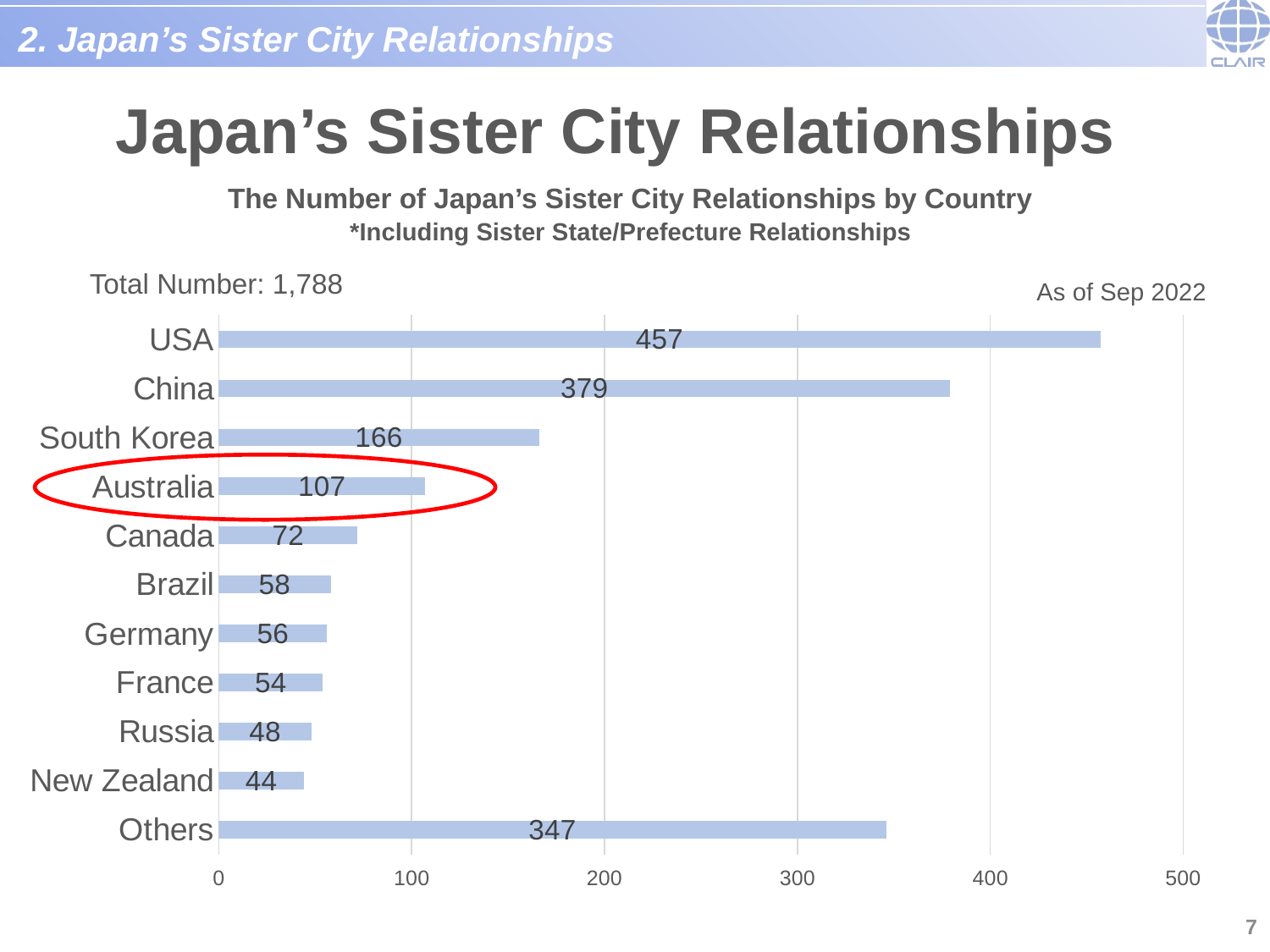
What kind of chart is shown on the slide? Bar chart How many sister city relationships does Japan have with the USA? 457 Which named country (excluding Others) has the lowest value on the chart? New Zealand What is the difference between the values for USA and China? 78 What is the value shown for Australia? 107 What is the value shown for New Zealand? 44 Is the value for Others greater or less than 300? greater What is the difference between the values for South Korea and Australia? 59 How many categories are shown on the chart? 11 Which is larger, the value for Canada or the value for Brazil? Canada Which country has the highest number of sister city relationships with Japan? USA Which category on the chart is circled in red? Australia